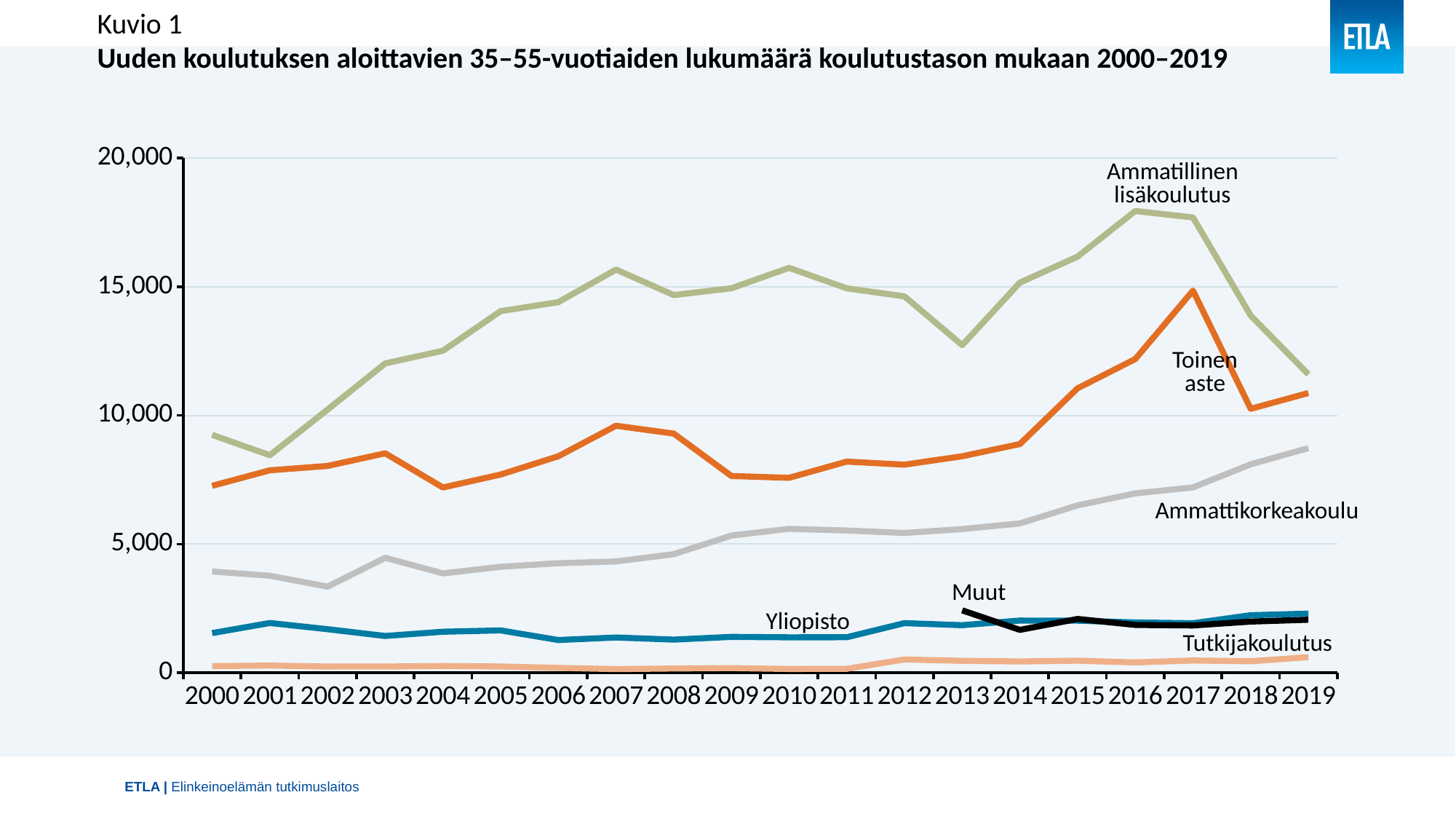
Is the value for Ammatillinen lisäkoulutus in 2016 greater or less than 15,000? greater Is the value for Ammattikorkeakoulu in 2019 greater or less than 5,000? greater In which year does the Muut series first appear on the chart? 2013 Which series has the highest value in 2016? Ammatillinen lisäkoulutus Is the value for Toinen aste in 2017 greater or less than 10,000? greater In which year does the Toinen aste line reach its peak? 2017 In 2010, which is larger: Yliopisto or Ammattikorkeakoulu? Ammattikorkeakoulu What kind of chart is shown on the slide? line chart Does the Ammatillinen lisäkoulutus line rise or fall from 2016 to 2019? fall How many series are labelled on the chart? 6 Which series has the lowest values across the whole period? Tutkijakoulutus How many years are shown on the x axis of the chart? 20